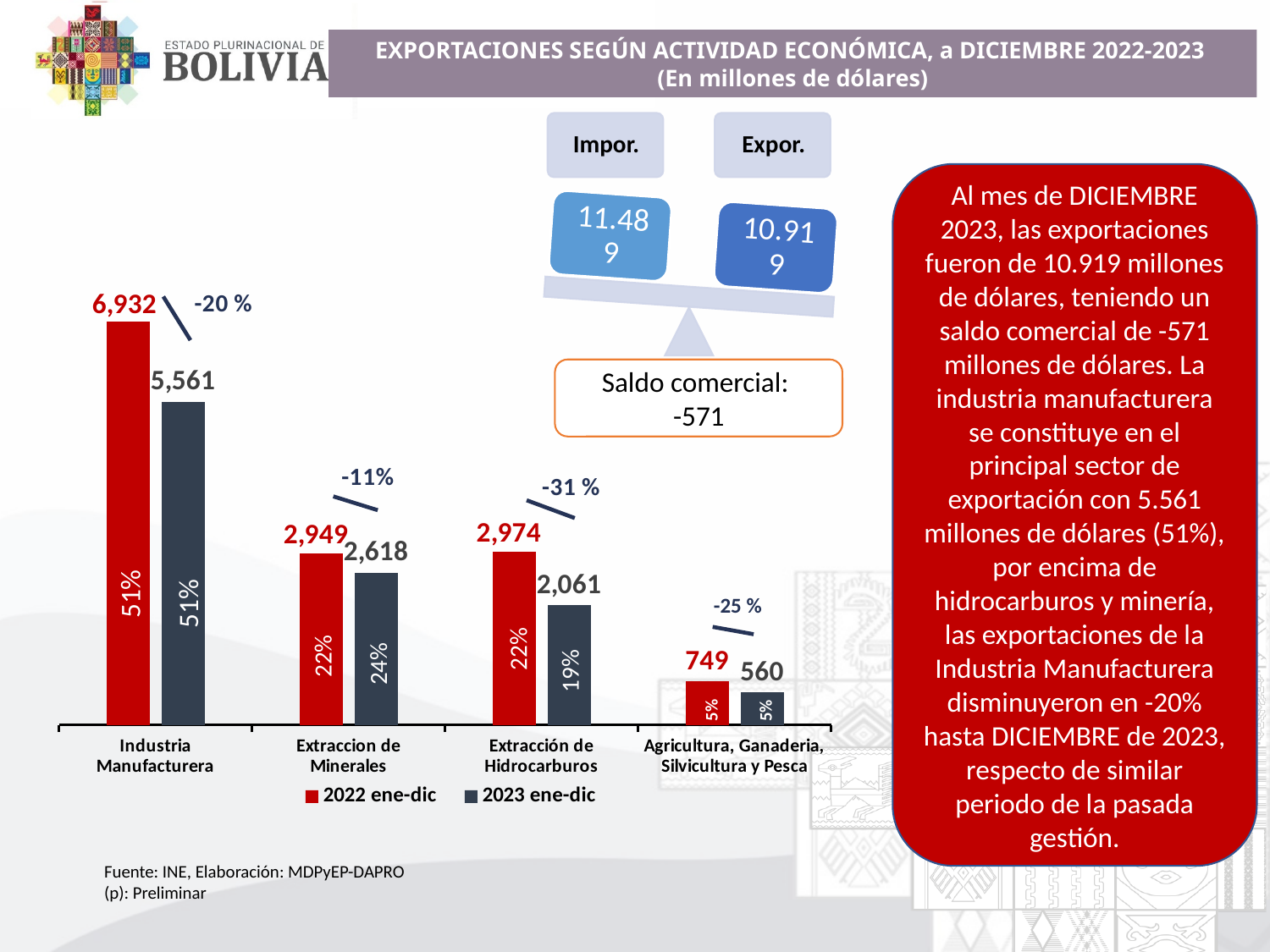
What kind of chart is used to show exports by economic activity? Bar chart Which category has the lowest 2023 ene-dic export value? Agricultura, Ganaderia, Silvicultura y Pesca Which category has the highest 2022 ene-dic export value? Industria Manufacturera What percentage change is shown above the Extracción de Hidrocarburos bars? -31 % How many categories are shown on the x axis of the bar chart? 4 What share label is printed inside the 2023 ene-dic bar for Extraccion de Minerales? 24% What is the 2023 ene-dic export value for Industria Manufacturera? 5,561 What is the difference between the 2022 ene-dic and 2023 ene-dic values for Industria Manufacturera? 1,371 What is the 2023 ene-dic value for Agricultura, Ganaderia, Silvicultura y Pesca? 560 How many series does the legend of the bar chart list? 2 What is the 2022 ene-dic export value for Extracción de Hidrocarburos? 2,974 Which is larger for 2023 ene-dic: Extraccion de Minerales or Extracción de Hidrocarburos? Extraccion de Minerales